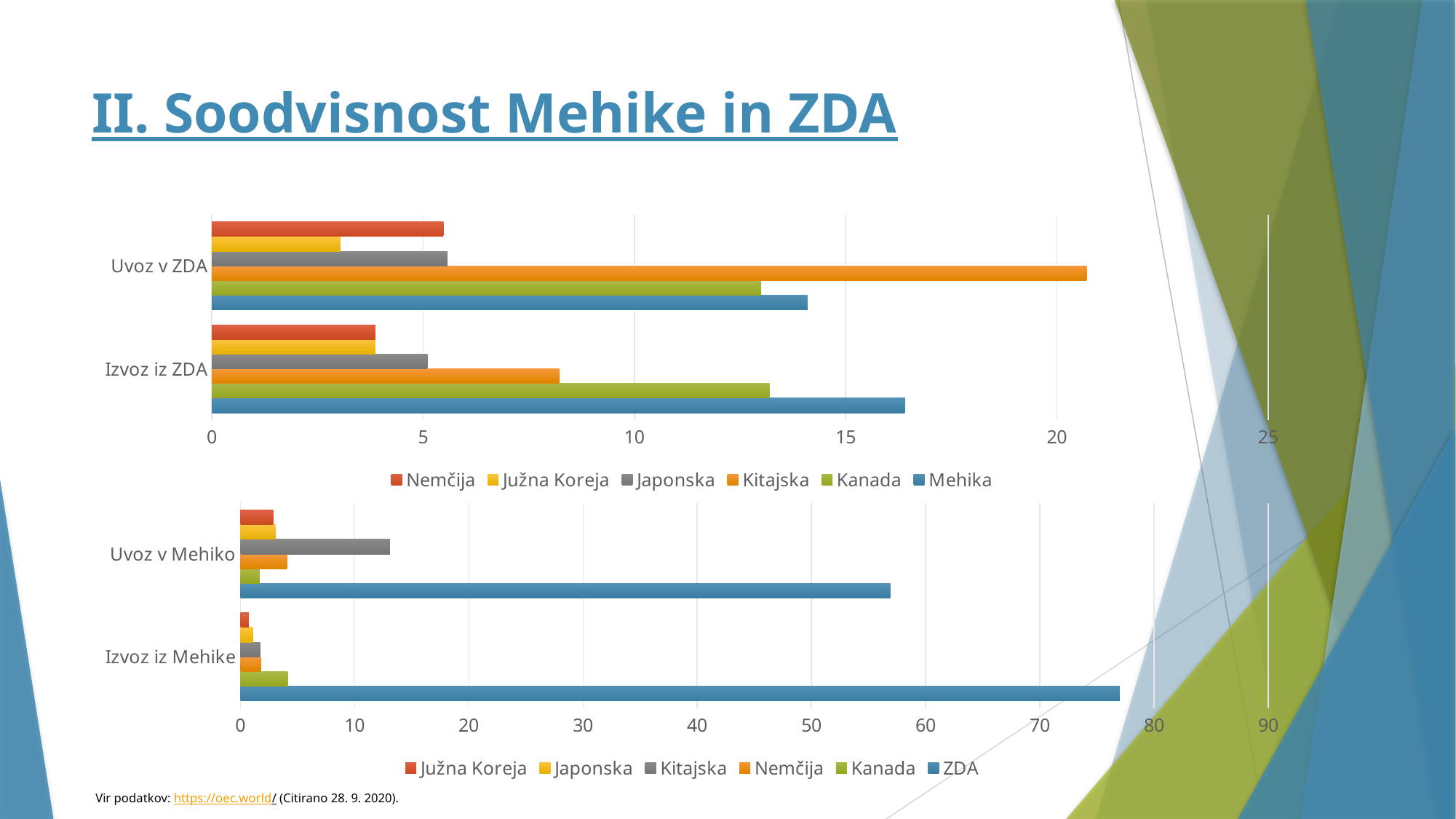
What kind of chart is the bottom chart? bar chart In the top chart, which series has the highest value for Uvoz v ZDA? Kitajska In the bottom chart, which series has the lowest value for Izvoz iz Mehike? Južna Koreja In the top chart, is the value for Kitajska under Uvoz v ZDA greater or less than 20? greater In the bottom chart, is the value for ZDA under Uvoz v Mehiko greater or less than 50? greater How many series does the legend of the top chart list? 6 In the bottom chart, which series has the highest value for Izvoz iz Mehike? ZDA In the bottom chart, for Uvoz v Mehiko, which is larger: Kitajska or Nemčija? Kitajska In the top chart, which series has the highest value for Izvoz iz ZDA? Mehika In the top chart, for Izvoz iz ZDA, which is larger: Kitajska or Kanada? Kanada In the top chart, is the value for Mehika under Izvoz iz ZDA greater or less than 15? greater How many categories are shown on the y axis of the top chart? 2